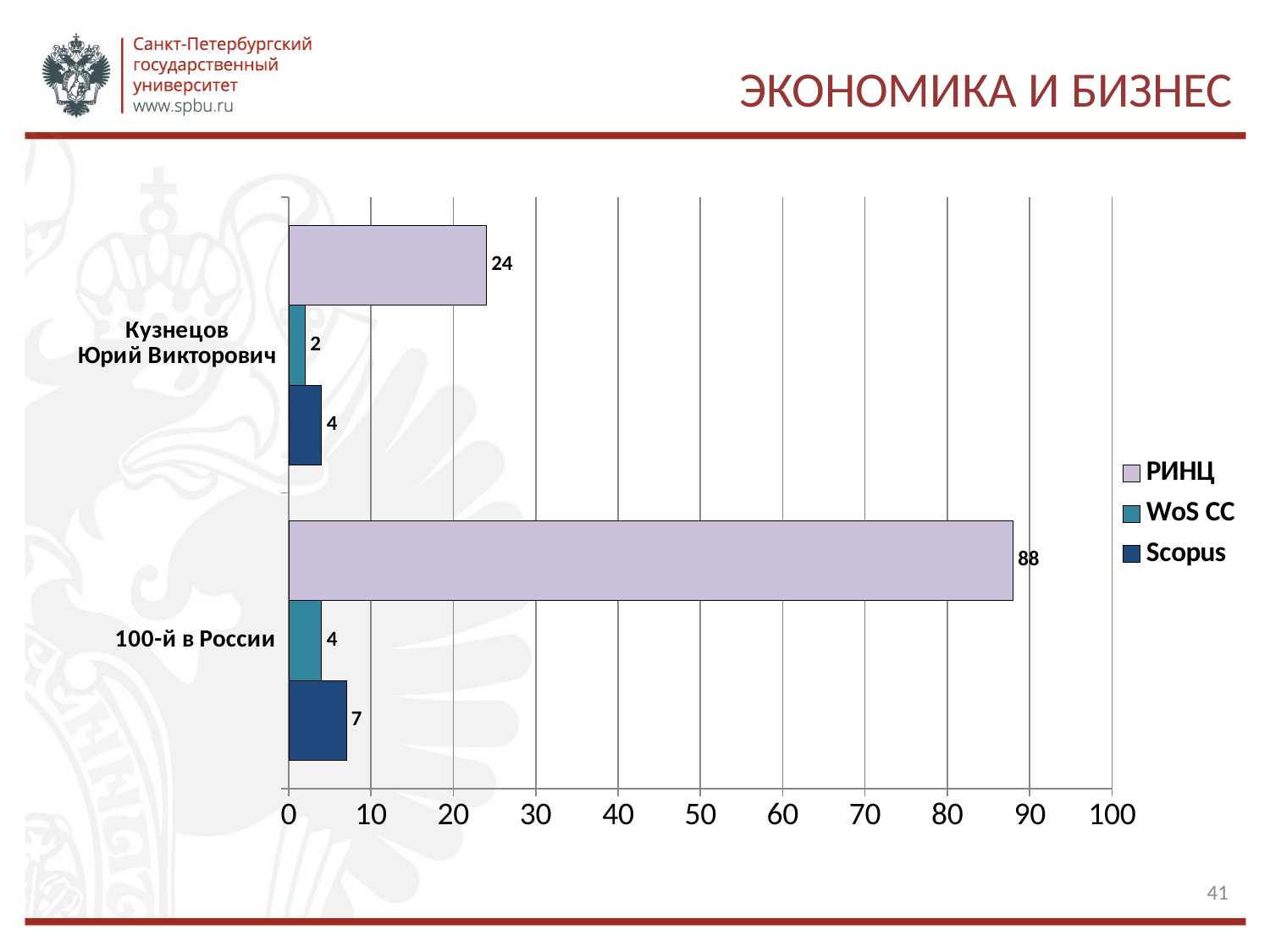
Which category has the highest РИНЦ value? 100-й в России Which series is shown in the lightest colour in the legend? РИНЦ Is the Scopus value larger for Кузнецов Юрий Викторович or for 100-й в России? 100-й в России Which series has the lowest value for Кузнецов Юрий Викторович? WoS CC What is the РИНЦ value for 100-й в России? 88 What kind of chart is shown on the slide? Bar chart How many categories are shown on the chart? 2 What is the Scopus value for 100-й в России? 7 How many series does the legend list? 3 What is the РИНЦ value for Кузнецов Юрий Викторович? 24 What is the difference between the РИНЦ values for 100-й в России and Кузнецов Юрий Викторович? 64 What is the WoS CC value for Кузнецов Юрий Викторович? 2